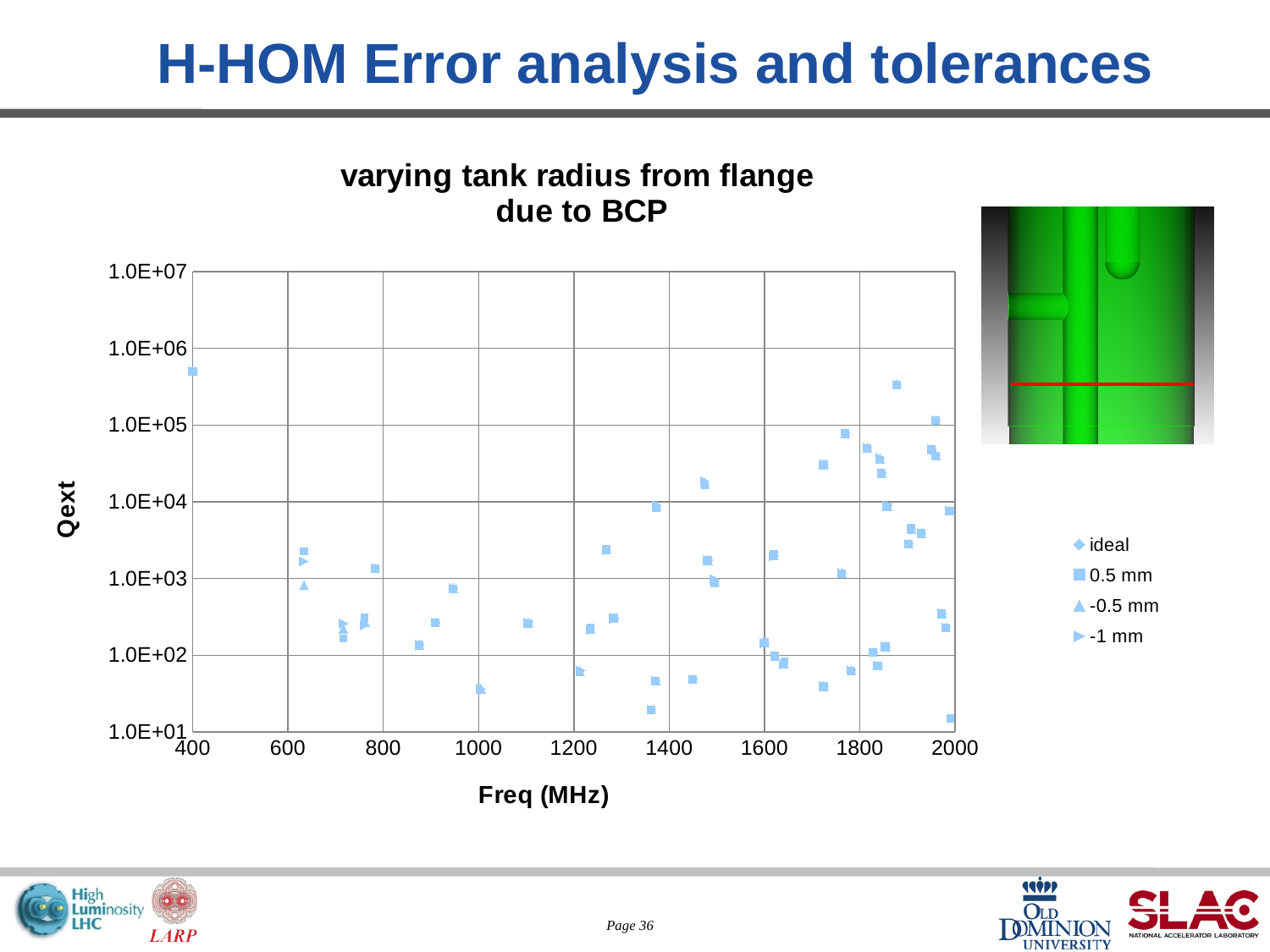
Is the Qext value of the point near 1000 MHz greater or less than 1.0E+02? less Which is larger: the Qext of the point at about 400 MHz or the Qext of the point at about 1000 MHz? the point at about 400 MHz What is the title of the chart? varying tank radius from flange due to BCP Is the Qext value of the highest point near 1880 MHz greater or less than 1.0E+05? greater How many series does the legend list? 4 Is the Qext value of the lowest point near 2000 MHz greater or less than 1.0E+02? less What label is on the vertical axis of the chart? Qext What kind of chart is shown on the slide? scatter chart What is the lowest value shown on the Qext axis? 1.0E+01